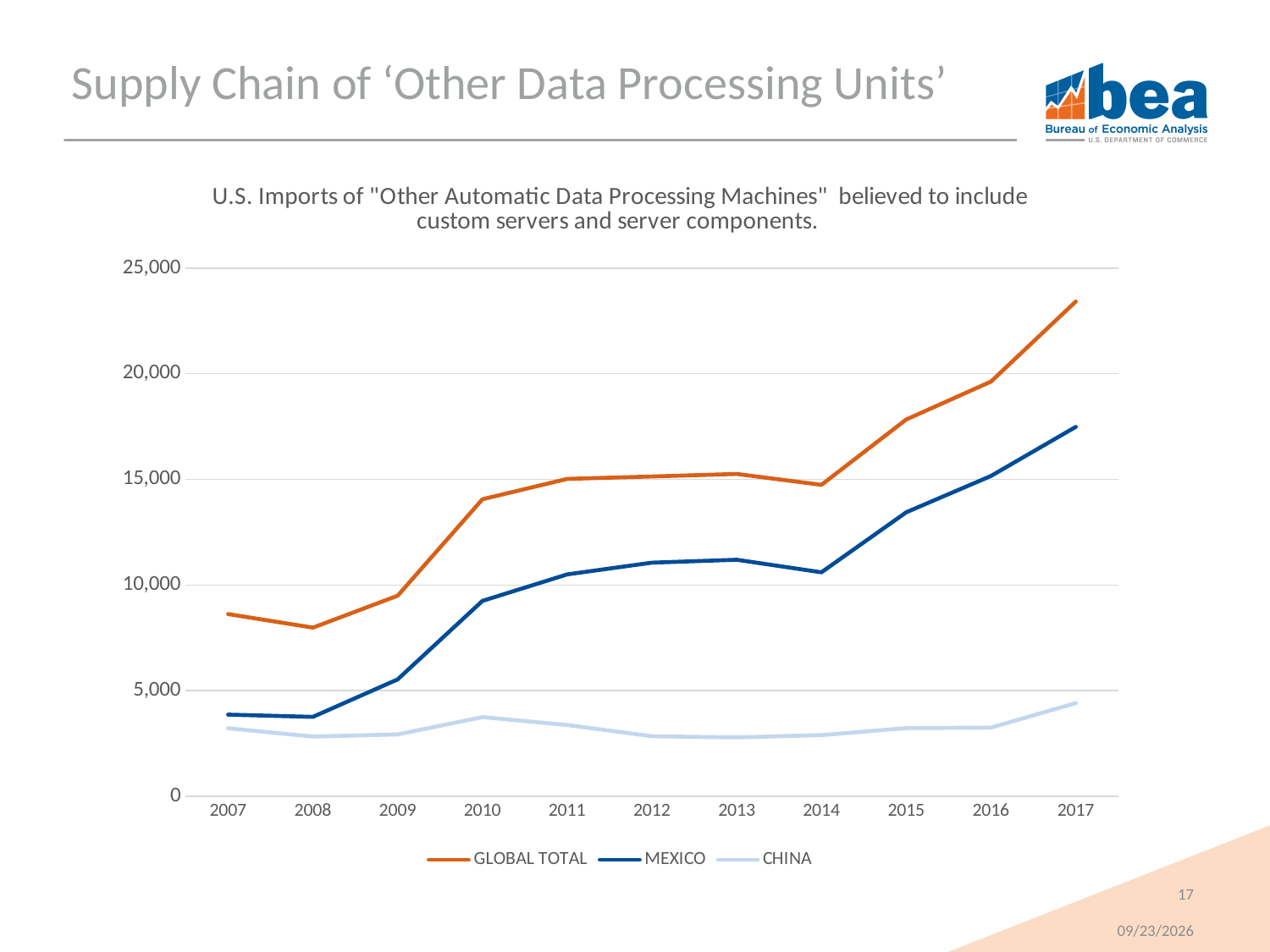
How many years are plotted along the x axis? 11 Is the CHINA value for 2017 greater or less than 5,000? less Is the GLOBAL TOTAL value for 2017 greater or less than 20,000? greater Which series has the larger value in 2017, MEXICO or CHINA? MEXICO Does the GLOBAL TOTAL line rise or fall from 2014 to 2017? rise In which year is the CHINA line at its highest? 2017 How many series does the legend list? 3 What kind of chart is shown on the slide? line chart Is the MEXICO value for 2017 greater or less than 15,000? greater In which year is the GLOBAL TOTAL line at its lowest? 2008 What colour is the GLOBAL TOTAL line in the legend? orange In which year is the GLOBAL TOTAL line at its highest? 2017